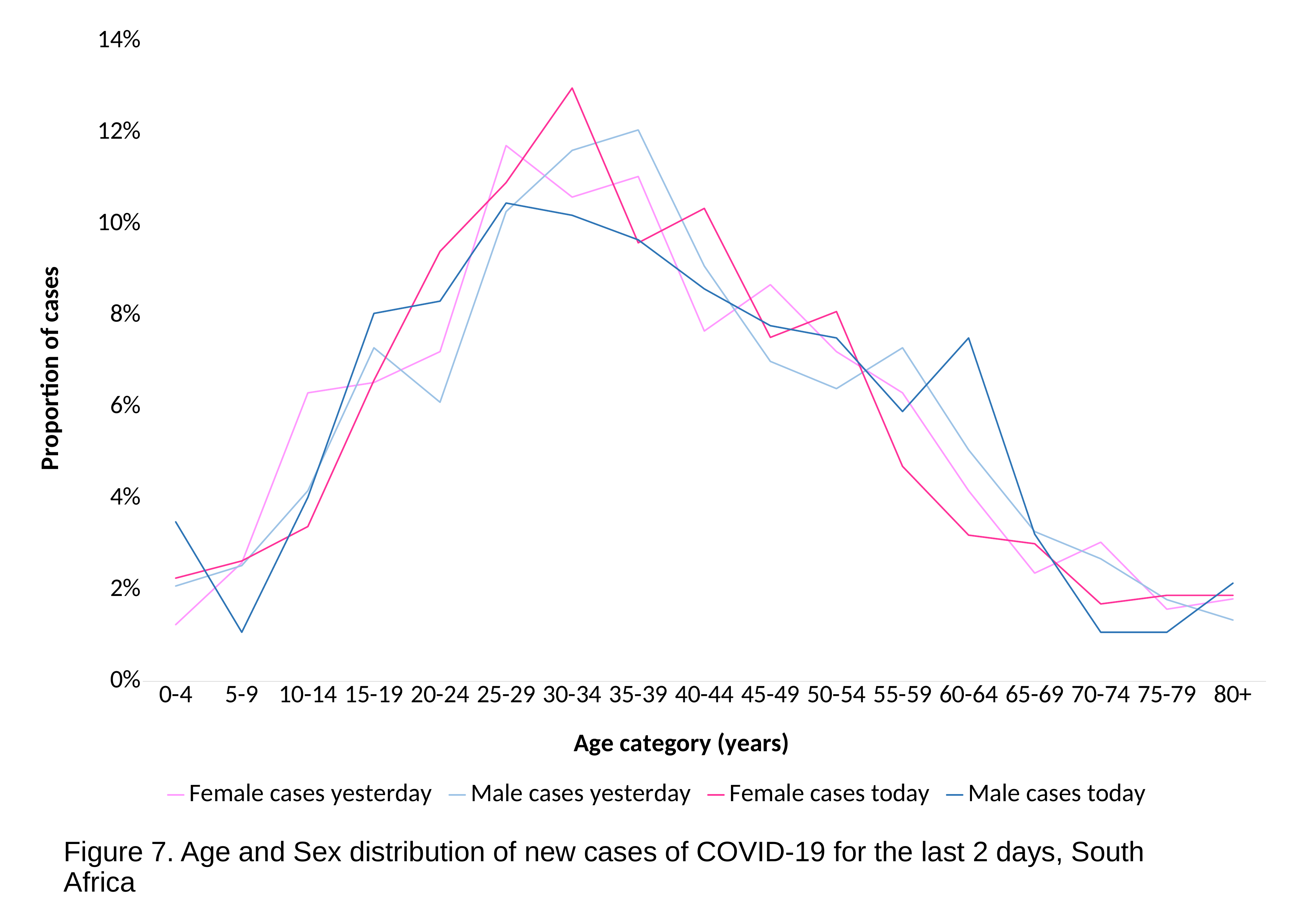
What is the label of the y axis? Proportion of cases In which age category does the Male cases yesterday series reach its lowest value? 80+ In which age category does the Female cases today series reach its highest value? 30-34 Is the value for Male cases today in the 5-9 age category greater or less than 2%? less Is the value for Female cases today in the 30-34 age category greater or less than 12%? greater How many series does the legend list? 4 Does the Female cases today series rise or fall from the 30-34 age category to the 80+ age category? Fall What kind of chart is shown on the slide? Line chart Is the value for Male cases today in the 60-64 age category greater or less than 6%? greater How many age categories are shown on the x axis? 17 In the 60-64 age category, which is larger: Male cases today or Female cases today? Male cases today In which age category does the Male cases yesterday series reach its highest value? 35-39